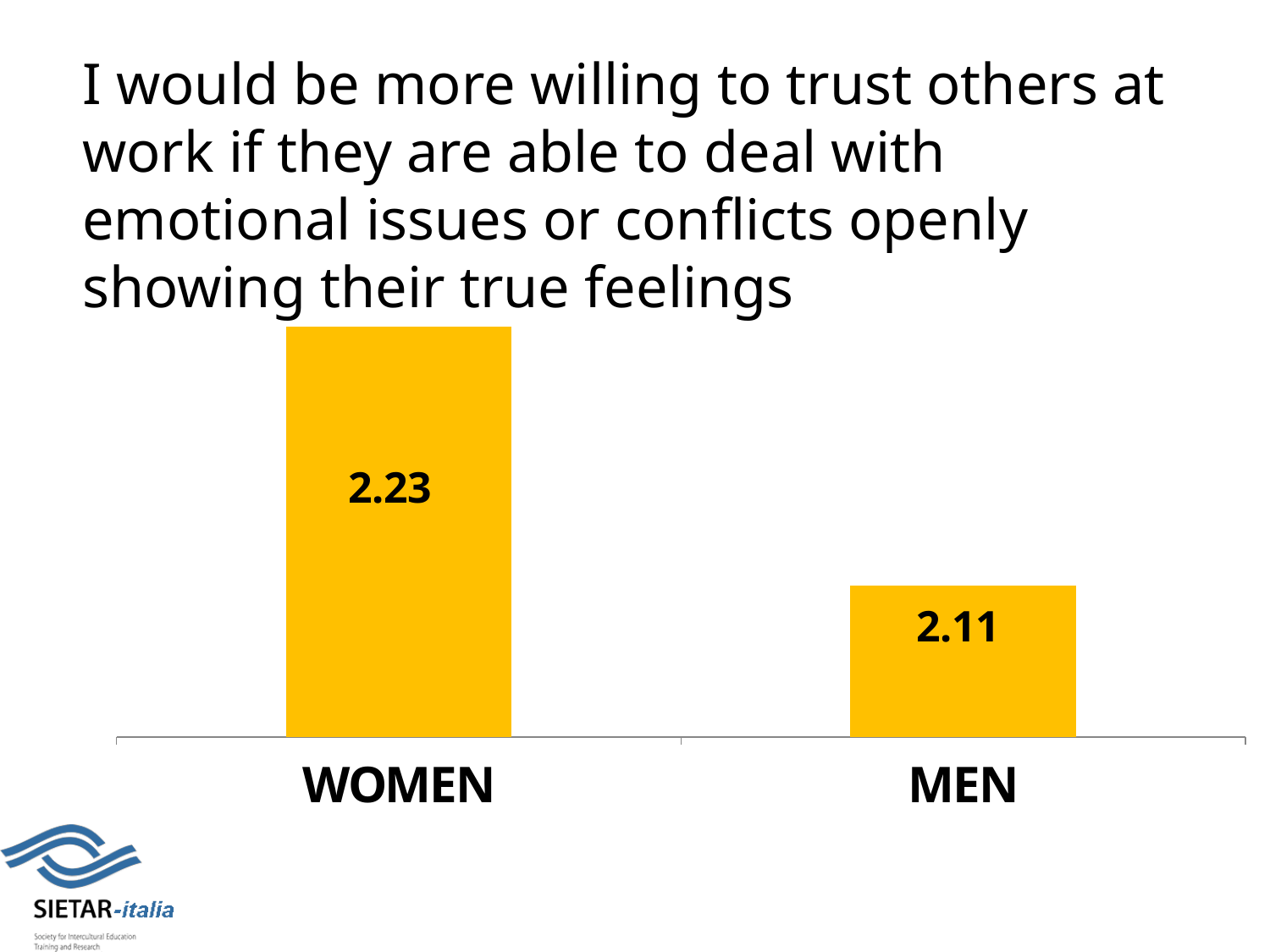
What kind of chart is shown on the slide? bar chart Which category has the highest value? WOMEN How many categories are shown on the x axis? 2 What is the difference between the values for WOMEN and MEN? 0.12 Do the values rise or fall from WOMEN to MEN? fall Which category has the lowest value? MEN What is the value for WOMEN? 2.23 What is the title of the chart? I would be more willing to trust others at work if they are able to deal with emotional issues or conflicts openly showing their true feelings What colour are the bars in the chart? yellow What is the value for MEN? 2.11 Which is larger, the value for WOMEN or the value for MEN? WOMEN